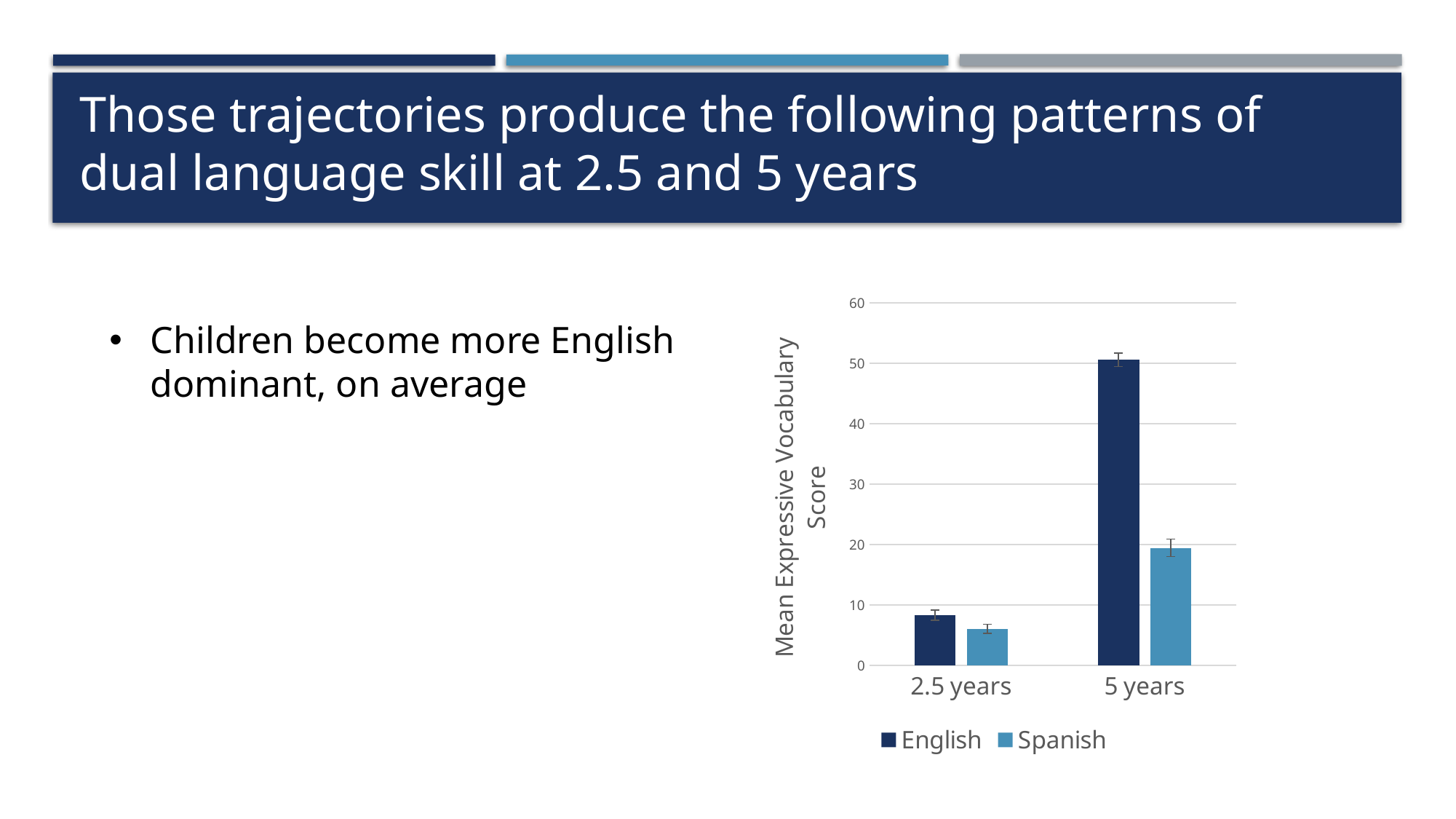
Which bar is the lowest in the chart? Spanish at 2.5 years Is the English score at 5 years greater or less than 40? greater How many series does the chart legend list? 2 What is the label on the vertical axis of the chart? Mean Expressive Vocabulary Score Which series has the highest bar in the chart? English How many age categories are shown on the x axis of the chart? 2 Is the Spanish score at 5 years greater or less than 30? less At 2.5 years, which is larger: the English score or the Spanish score? English Is the English score at 2.5 years greater or less than 10? less At 5 years, which is larger: the English score or the Spanish score? English What kind of chart is shown on the slide? bar chart Do the English scores rise or fall from 2.5 years to 5 years? rise